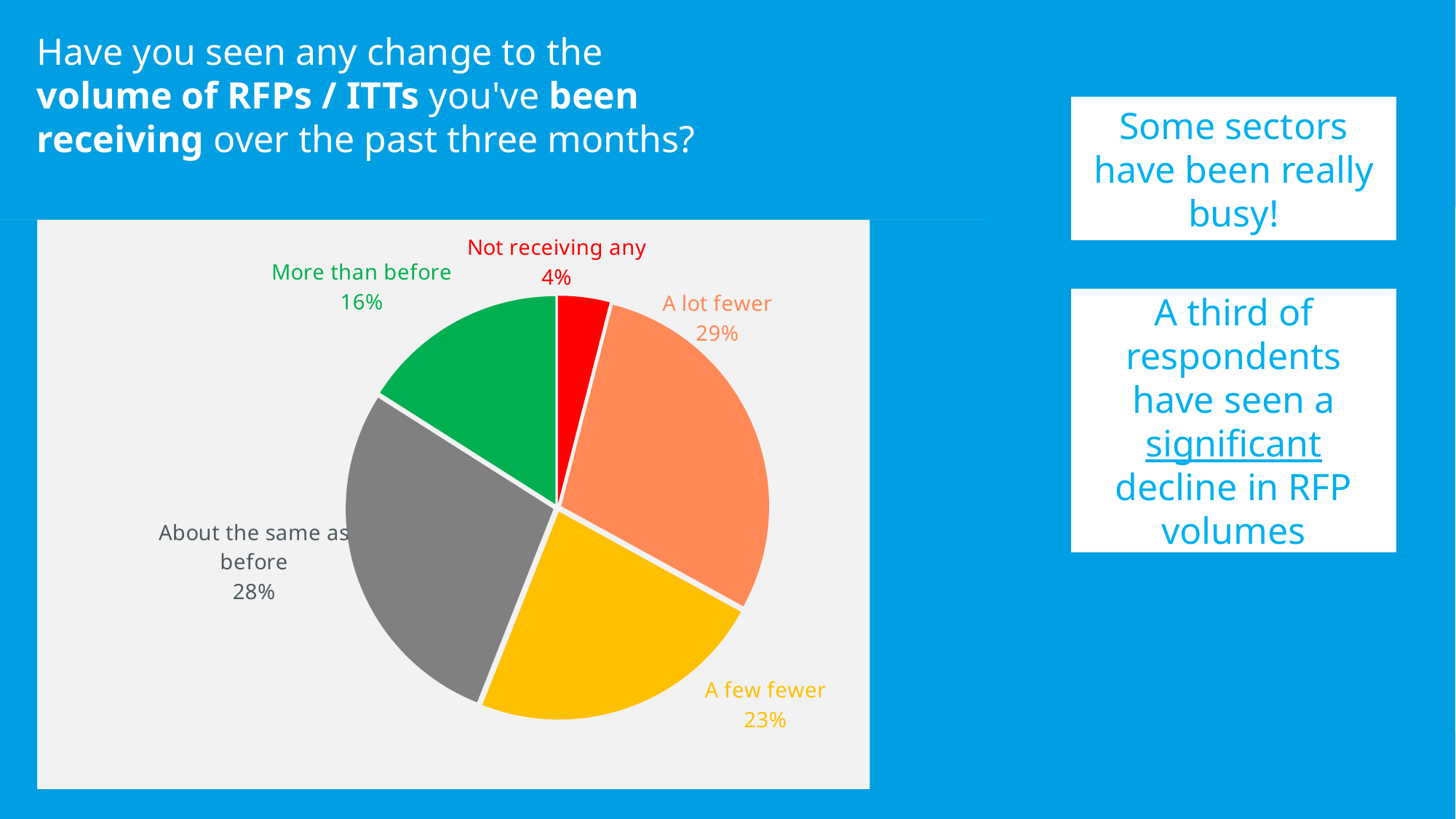
Which response category has the largest slice of the pie? A lot fewer What is the difference in percentage points between 'A lot fewer' and 'A few fewer'? 6 How many slices does the pie chart have? 5 What share of respondents said 'A few fewer'? 23% Which is larger: the share for 'More than before' or the share for 'A few fewer'? A few fewer Which response category has the smallest slice of the pie? Not receiving any What kind of chart is shown on the slide? pie chart What share of respondents said 'Not receiving any'? 4% What share of respondents said 'More than before'? 16% What colour is the 'About the same as before' slice? grey What share of respondents said 'About the same as before'? 28% What share of respondents said they are receiving 'A lot fewer' RFPs / ITTs? 29%